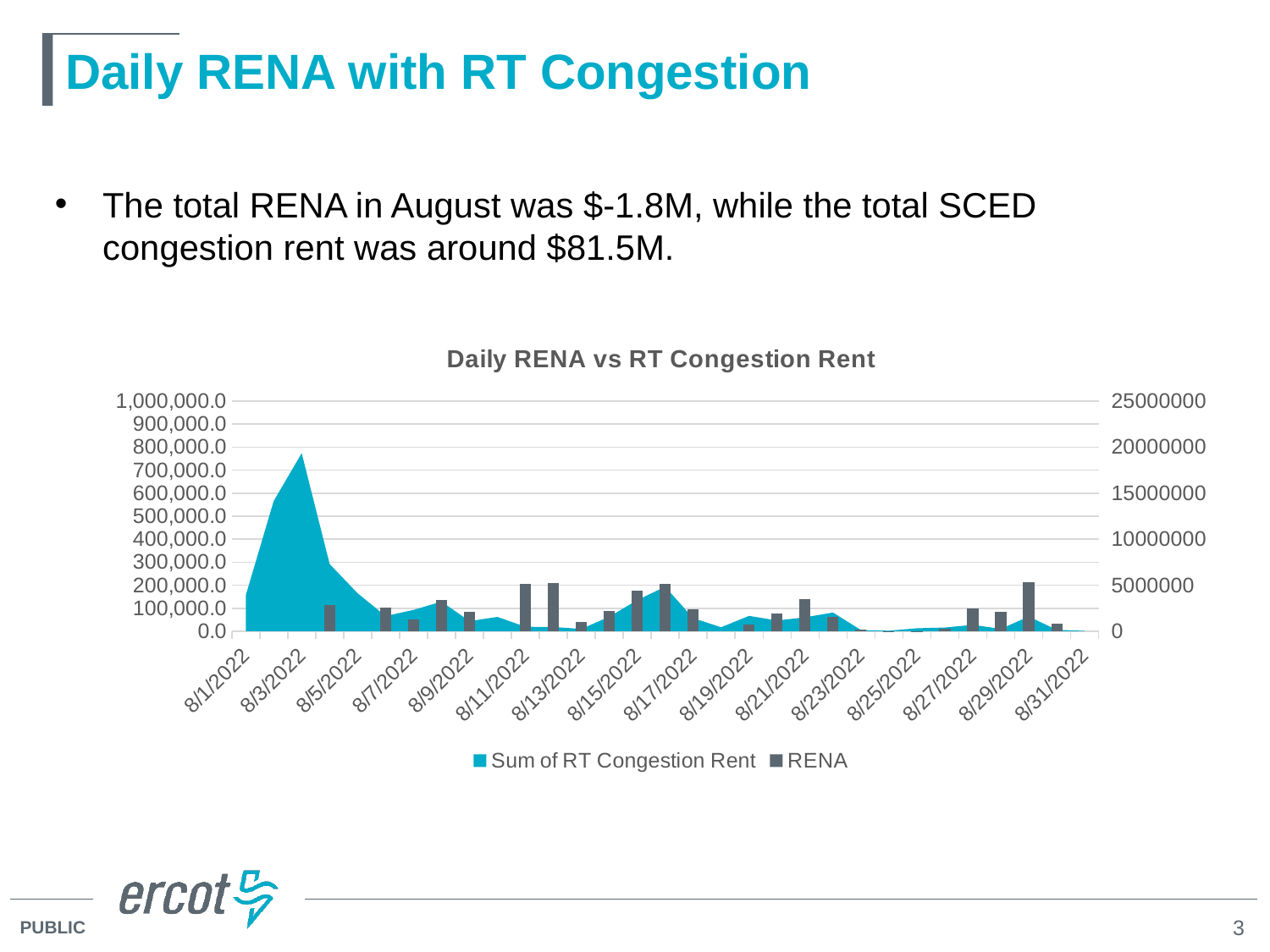
What kind of chart is shown on the slide? A combination area and bar chart What is the highest value shown on the left vertical axis of the chart? 1,000,000.0 What are the two series named in the chart legend? Sum of RT Congestion Rent and RENA How many date labels are shown along the x axis of the chart? 16 On which date does the Sum of RT Congestion Rent area reach its highest point? 8/3/2022 What is the highest value shown on the right vertical axis of the chart? 25000000 Which date has the taller RENA bar, 8/16/2022 or 8/6/2022? 8/16/2022 Does the Sum of RT Congestion Rent rise or fall between 8/1/2022 and 8/3/2022? Rise How many series does the chart legend list? 2 Does the Sum of RT Congestion Rent generally rise or fall from 8/3/2022 to 8/31/2022? Fall Which date has the larger Sum of RT Congestion Rent, 8/3/2022 or 8/25/2022? 8/3/2022